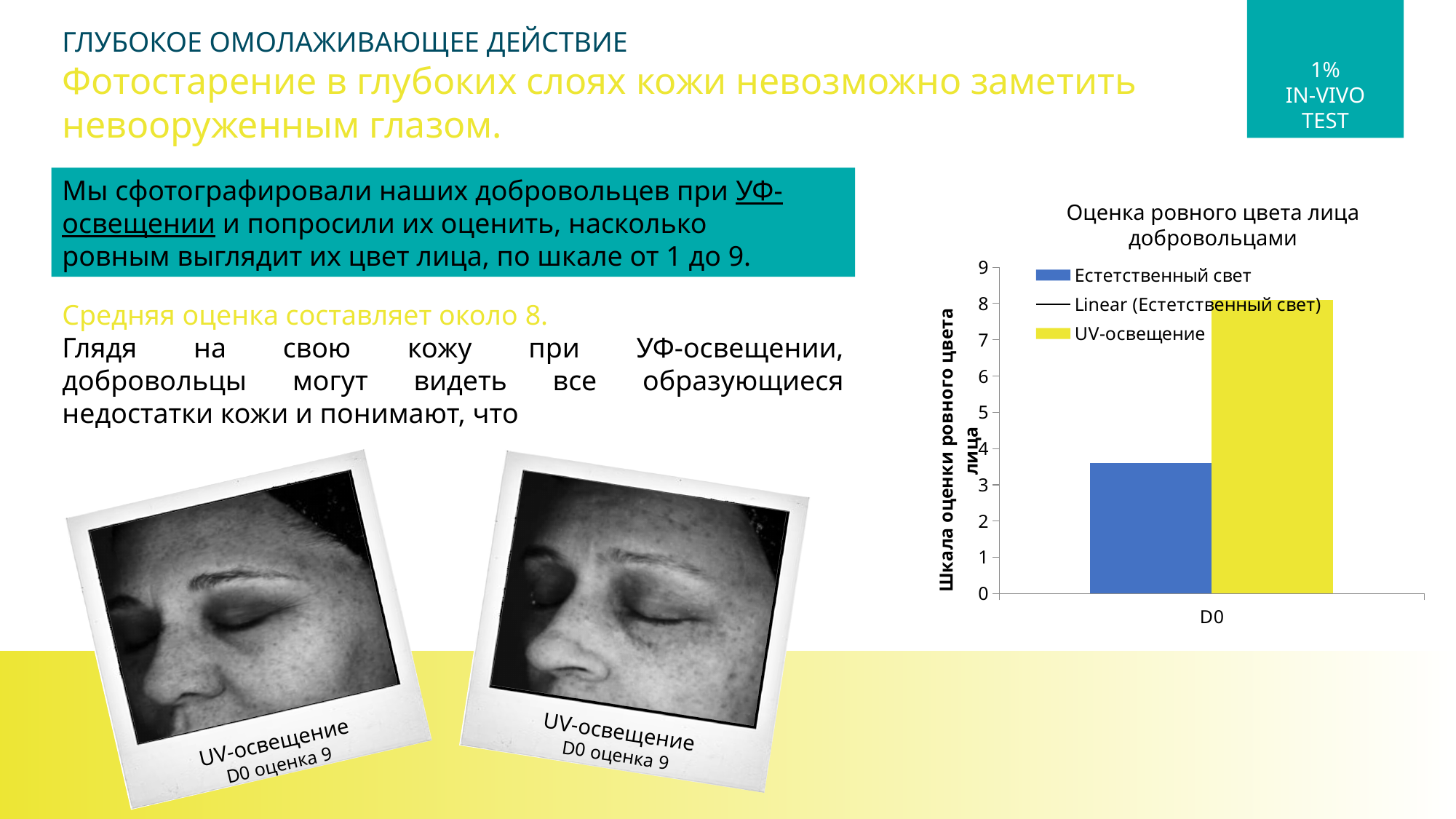
Is the value for UV-освещение at D0 greater or less than 7? greater Which series has the lowest bar in the chart? Естетственный свет What is the label of the category on the x axis? D0 What is the title of the chart? Оценка ровного цвета лица добровольцами Which series has the higher bar at D0, Естетственный свет or UV-освещение? UV-освещение Is the value for Естетственный свет at D0 greater or less than 4? less What kind of chart is shown on the slide? bar chart How many categories are shown on the x axis of the chart? 1 Is the value for Естетственный свет at D0 greater or less than 3? greater How many entries does the chart legend list? 3